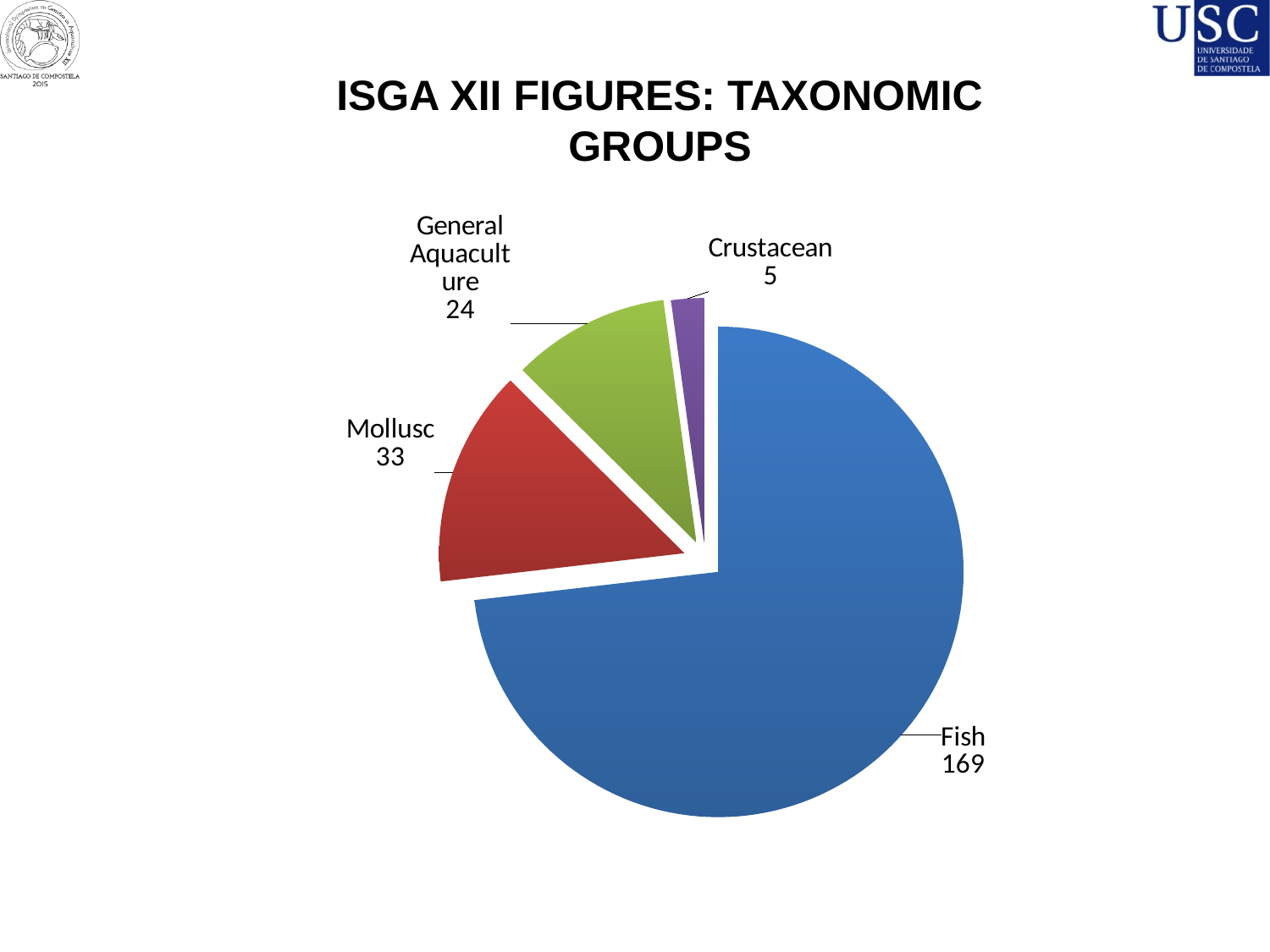
What is the value for General Aquaculture in the pie chart? 24 What is the value for Fish in the pie chart? 169 How many slices does the pie chart have? 4 What is the value for Mollusc in the pie chart? 33 Which is larger, the value for Mollusc or the value for Crustacean? Mollusc What is the value for Crustacean in the pie chart? 5 What type of chart is shown on the slide? pie chart What is the total of all the values shown in the pie chart? 231 Which taxonomic group has the smallest slice of the pie chart? Crustacean Which taxonomic group has the largest slice of the pie chart? Fish What is the title of the slide containing the pie chart? ISGA XII FIGURES: TAXONOMIC GROUPS What is the difference between the values for Mollusc and General Aquaculture? 9